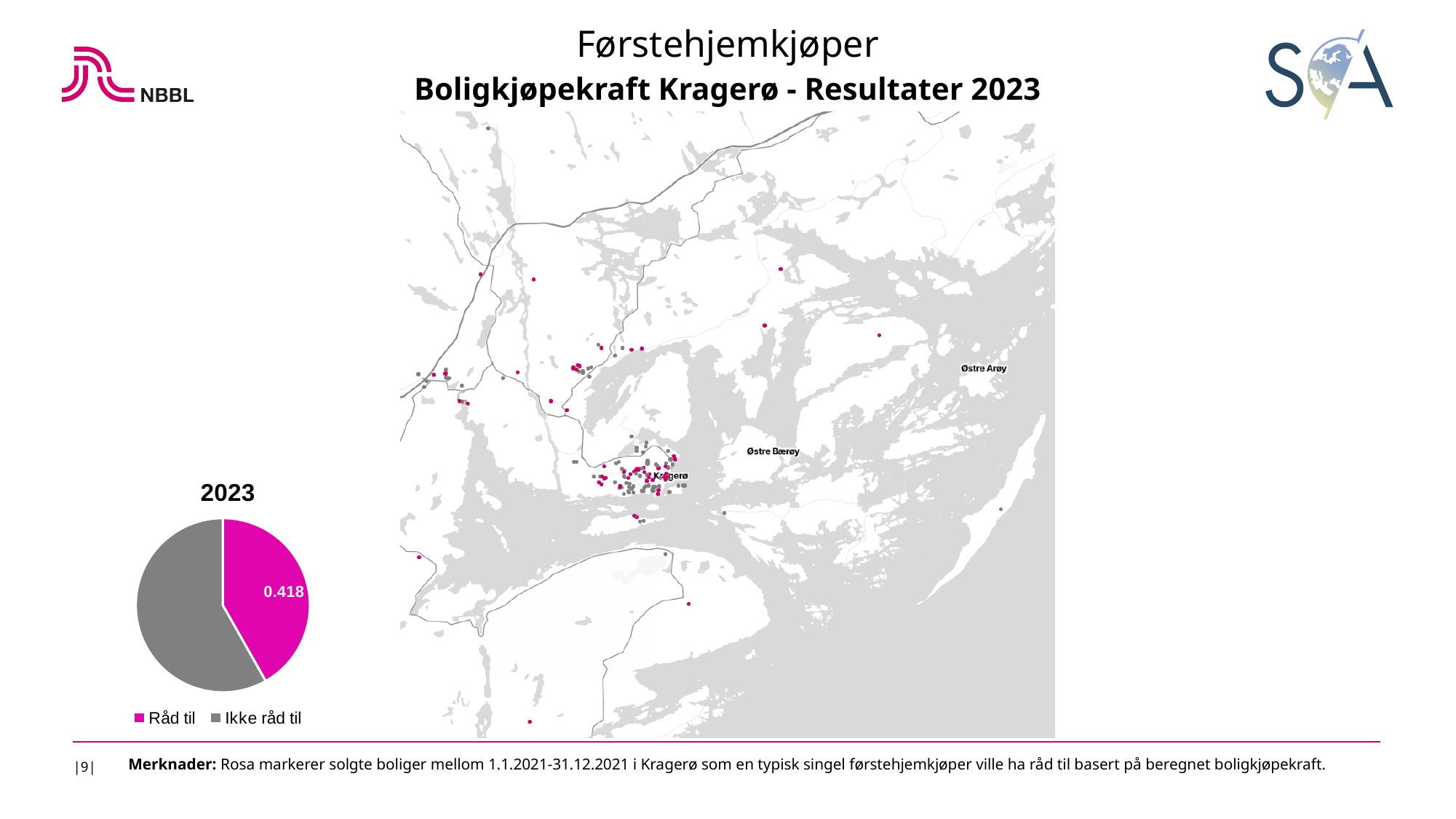
In the 2023 pie chart, what value is shown for the Råd til slice? 0.418 How many slices does the 2023 pie chart have? 2 In the 2023 pie chart, which slice is larger: Råd til or Ikke råd til? Ikke råd til In the 2023 pie chart, which slice is the largest? Ikke råd til What kind of chart is shown on the left of the slide under the heading 2023? Pie chart In the 2023 pie chart, what colour is the Råd til slice? Pink How many entries does the legend of the 2023 pie chart list? 2 In the 2023 pie chart, which slice is the smallest? Råd til What is the title shown above the pie chart? 2023